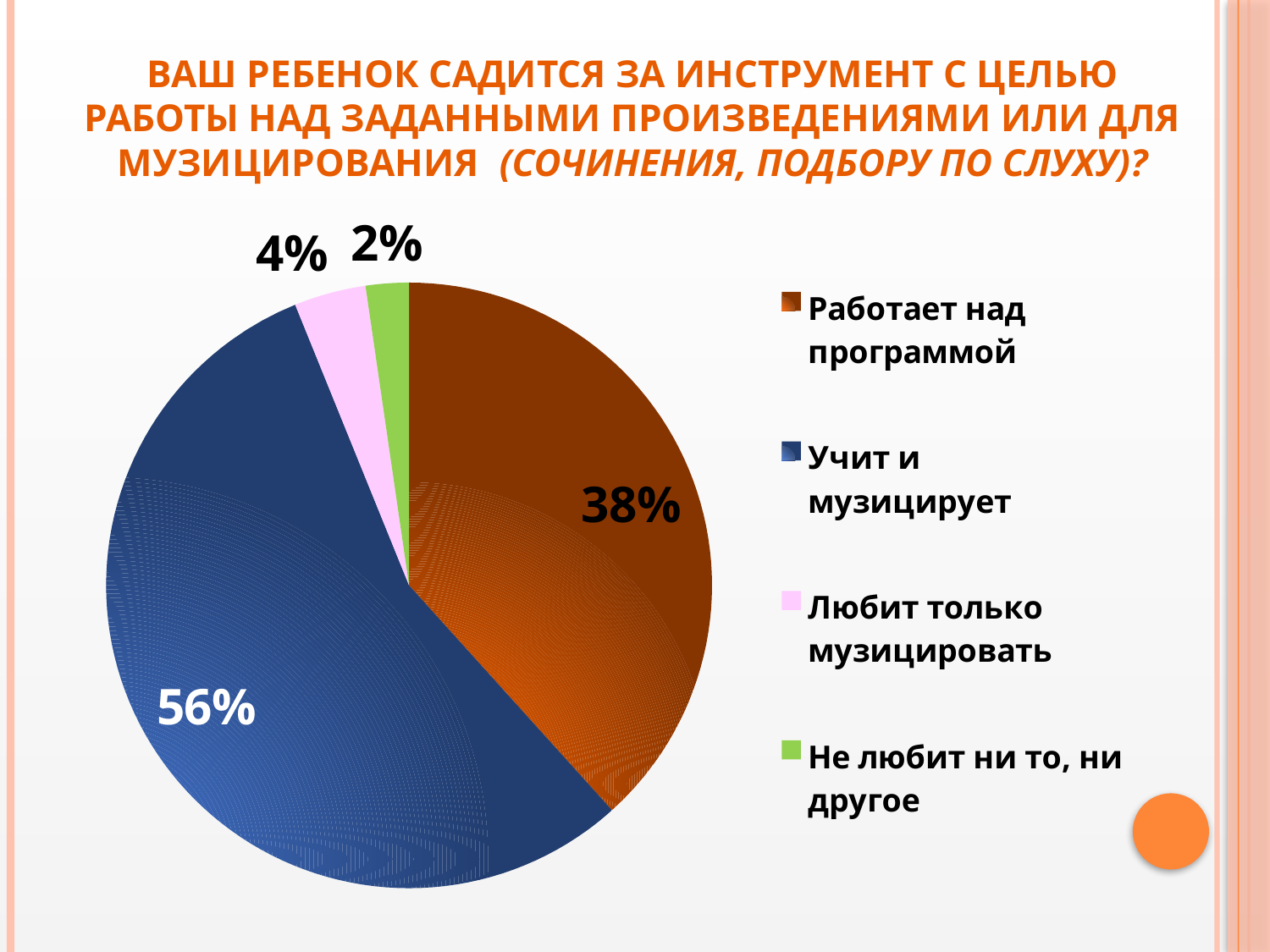
How many slices does the pie chart have? 4 How many entries does the legend list? 4 What share of the pie is labelled "Учит и музицирует"? 56% What share of the pie is labelled "Любит только музицировать"? 4% What colour is the slice for "Работает над программой"? brown/orange What is the difference between the shares for "Учит и музицирует" and "Работает над программой"? 18% What kind of chart is shown on the slide? pie chart What share of the pie is labelled "Работает над программой"? 38% Which category has the largest slice of the pie? Учит и музицирует Which is larger: the share for "Любит только музицировать" or the share for "Не любит ни то, ни другое"? Любит только музицировать Which category has the smallest slice of the pie? Не любит ни то, ни другое What share of the pie is labelled "Не любит ни то, ни другое"? 2%